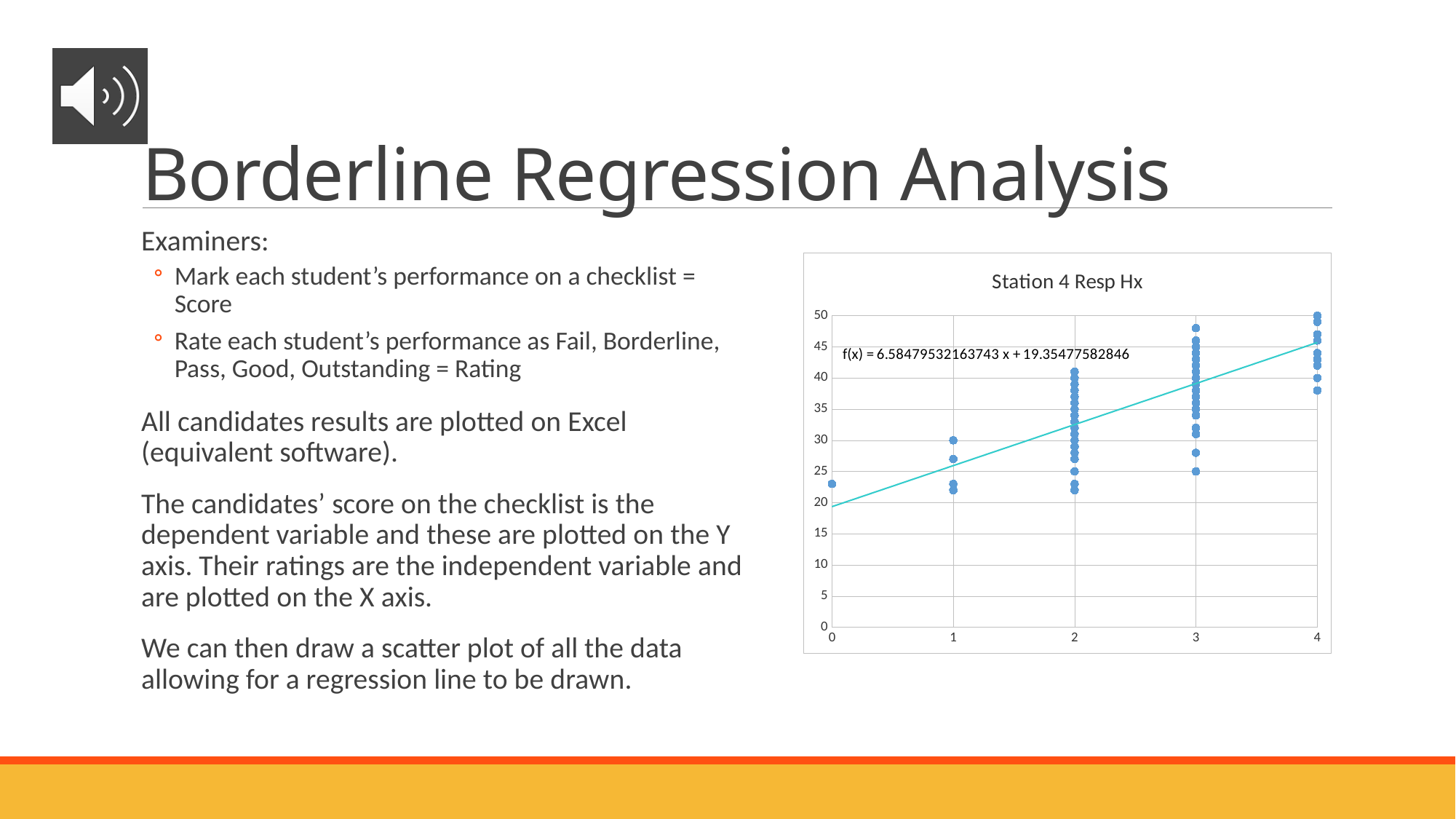
Is the plotted value at x = 0 greater or less than 25? less Which has a higher maximum plotted value: x = 1 or x = 3? x = 3 Do the plotted values generally rise or fall as the x value increases from 0 to 4? Rise Is the highest plotted value at x = 3 greater or less than 45? greater Is the highest plotted value at x = 2 greater or less than 45? less How many distinct x-axis values have points plotted on the chart? 5 What is the equation of the trendline shown on the chart? f(x) = 6.58479532163743 x + 19.35477582846 At which x value is the highest plotted point found? 4 What kind of chart is shown on the slide? Scatter plot What is the title of the chart? Station 4 Resp Hx